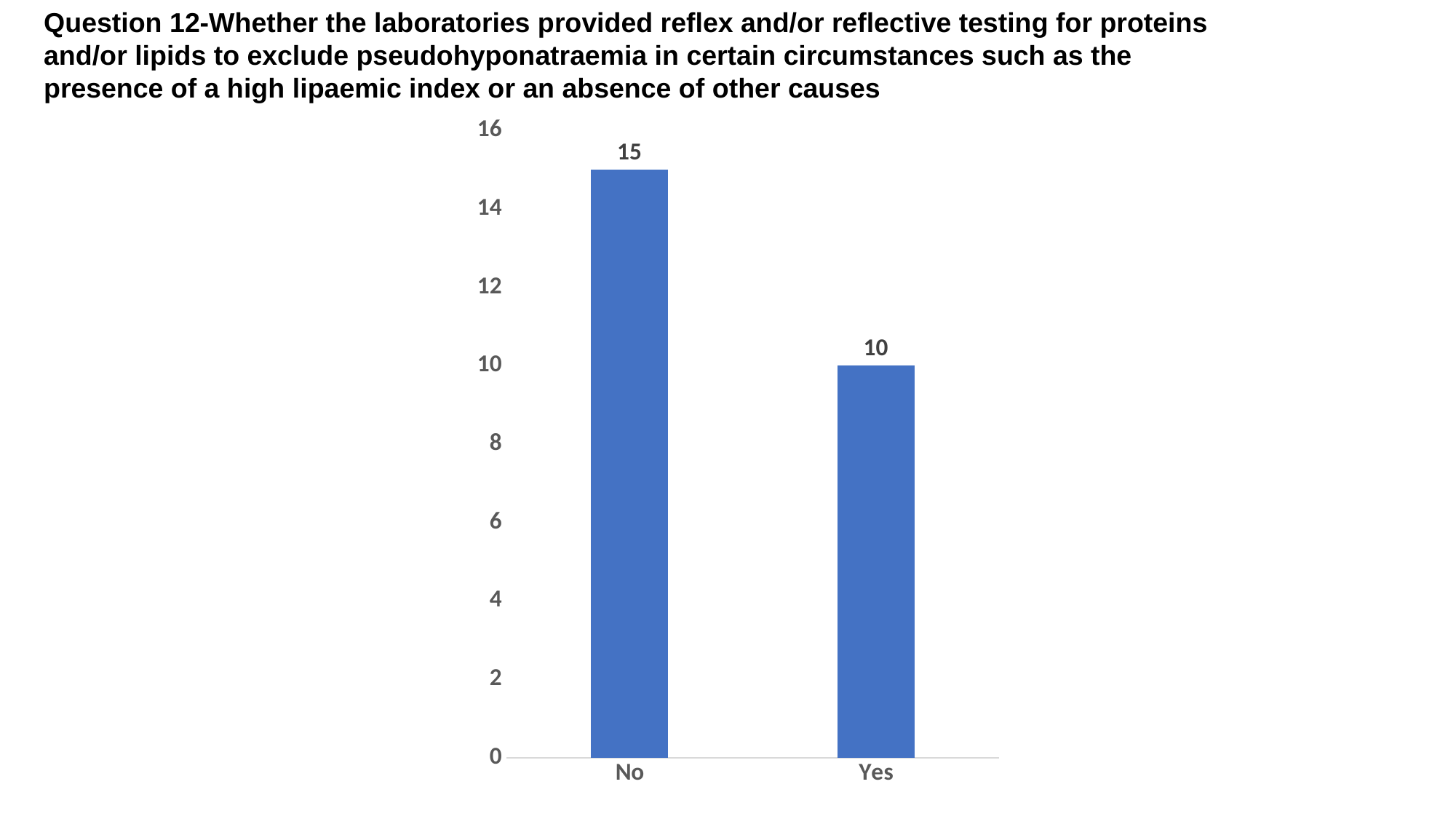
What colour are the bars in the chart? Blue Is the value for "Yes" greater or less than 14? less What is the value for the "Yes" category? 10 What is the maximum value shown on the y axis? 16 Which is larger, the value for "No" or the value for "Yes"? No What is the value for the "No" category? 15 Which category has the lowest value? Yes How many categories are shown on the x axis? 2 Is the value for "No" greater or less than 12? greater What is the difference between the values for "No" and "Yes"? 5 What kind of chart is shown on the slide? Bar chart Which category has the highest value? No